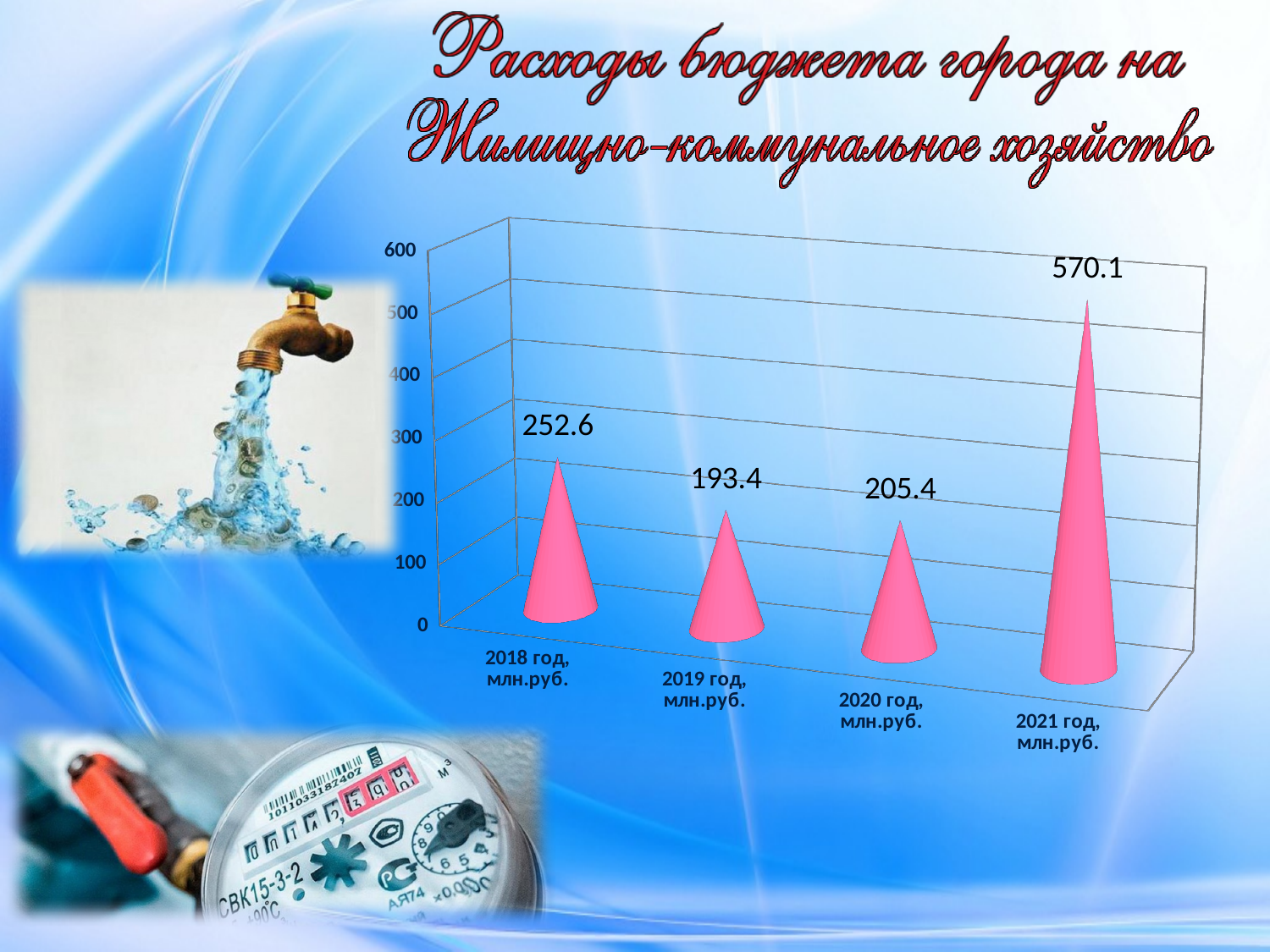
What is the value for 2018 год, млн.руб.? 252.6 What is the value for 2021 год, млн.руб.? 570.1 Is the value for 2021 год greater or less than 500? greater What is the value for 2019 год, млн.руб.? 193.4 What kind of chart is shown on the slide? bar chart What is the difference between the values for 2020 год and 2019 год? 12 What is the value for 2020 год, млн.руб.? 205.4 What is the difference between the values for 2021 год and 2018 год? 317.5 Which year has the highest value? 2021 год, млн.руб. Which is larger, the value for 2018 год or the value for 2020 год? 2018 год, млн.руб. Which year has the lowest value? 2019 год, млн.руб. How many years are shown on the chart? 4